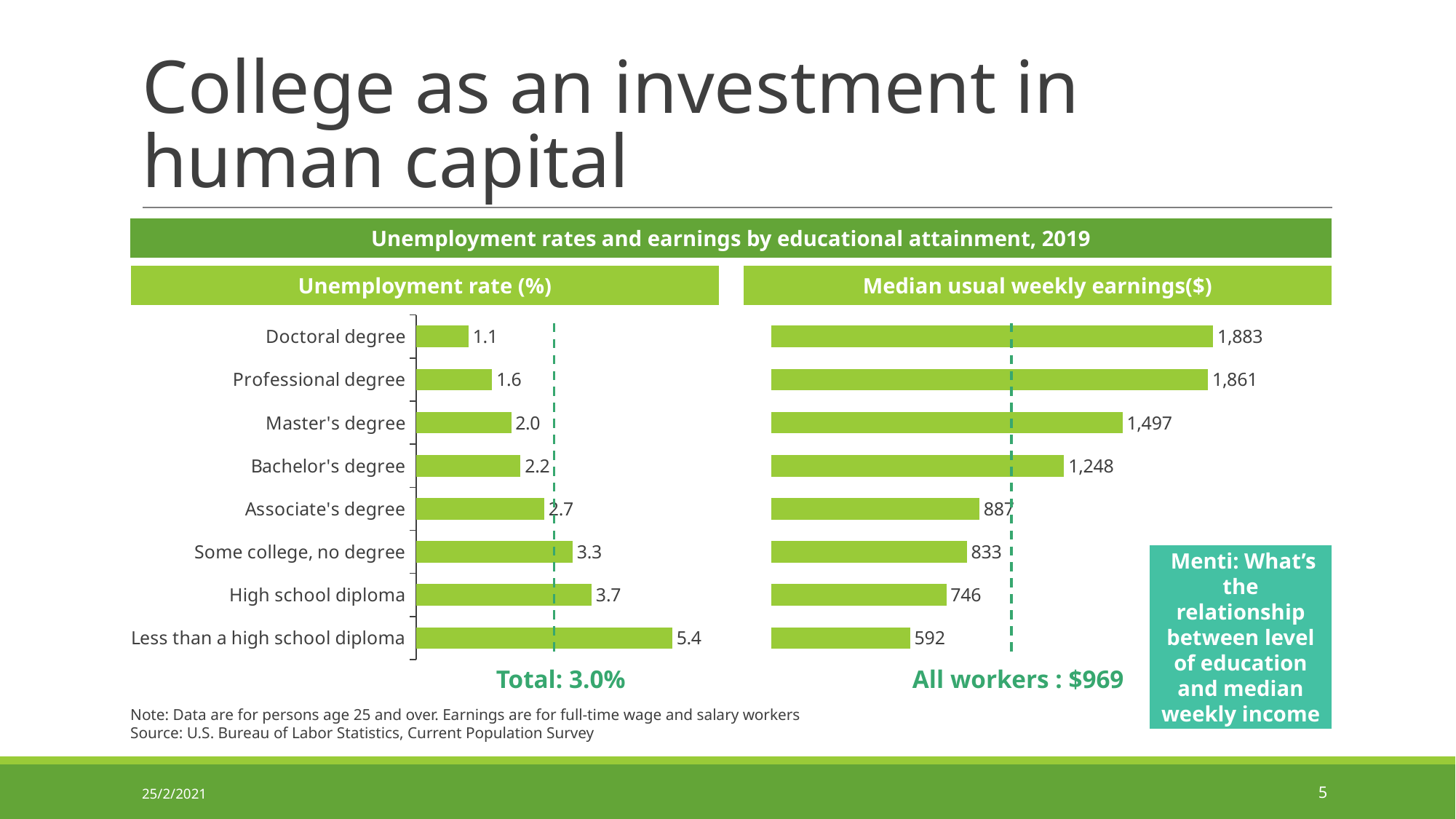
In the Median usual weekly earnings($) chart, what are the median weekly earnings shown for all workers? $969 What type of chart is the Median usual weekly earnings($) chart? Bar chart How many educational attainment categories are shown in the Unemployment rate (%) chart? 8 In the Unemployment rate (%) chart, what is the unemployment rate for a Bachelor's degree? 2.2 In the Median usual weekly earnings($) chart, what are the median usual weekly earnings for a Master's degree? 1,497 In the Median usual weekly earnings($) chart, which category has the lowest median weekly earnings? Less than a high school diploma In the Unemployment rate (%) chart, what is the difference between the unemployment rate for Less than a high school diploma and for a Doctoral degree? 4.3 In the Median usual weekly earnings($) chart, what is the difference in median weekly earnings between a Bachelor's degree and a High school diploma? 502 In the Unemployment rate (%) chart, which category has the lowest unemployment rate? Doctoral degree In the Unemployment rate (%) chart, which category has the highest unemployment rate? Less than a high school diploma In the Unemployment rate (%) chart, what is the total unemployment rate shown for all workers? 3.0% In the Median usual weekly earnings($) chart, which has higher median weekly earnings: Associate's degree or Some college, no degree? Associate's degree